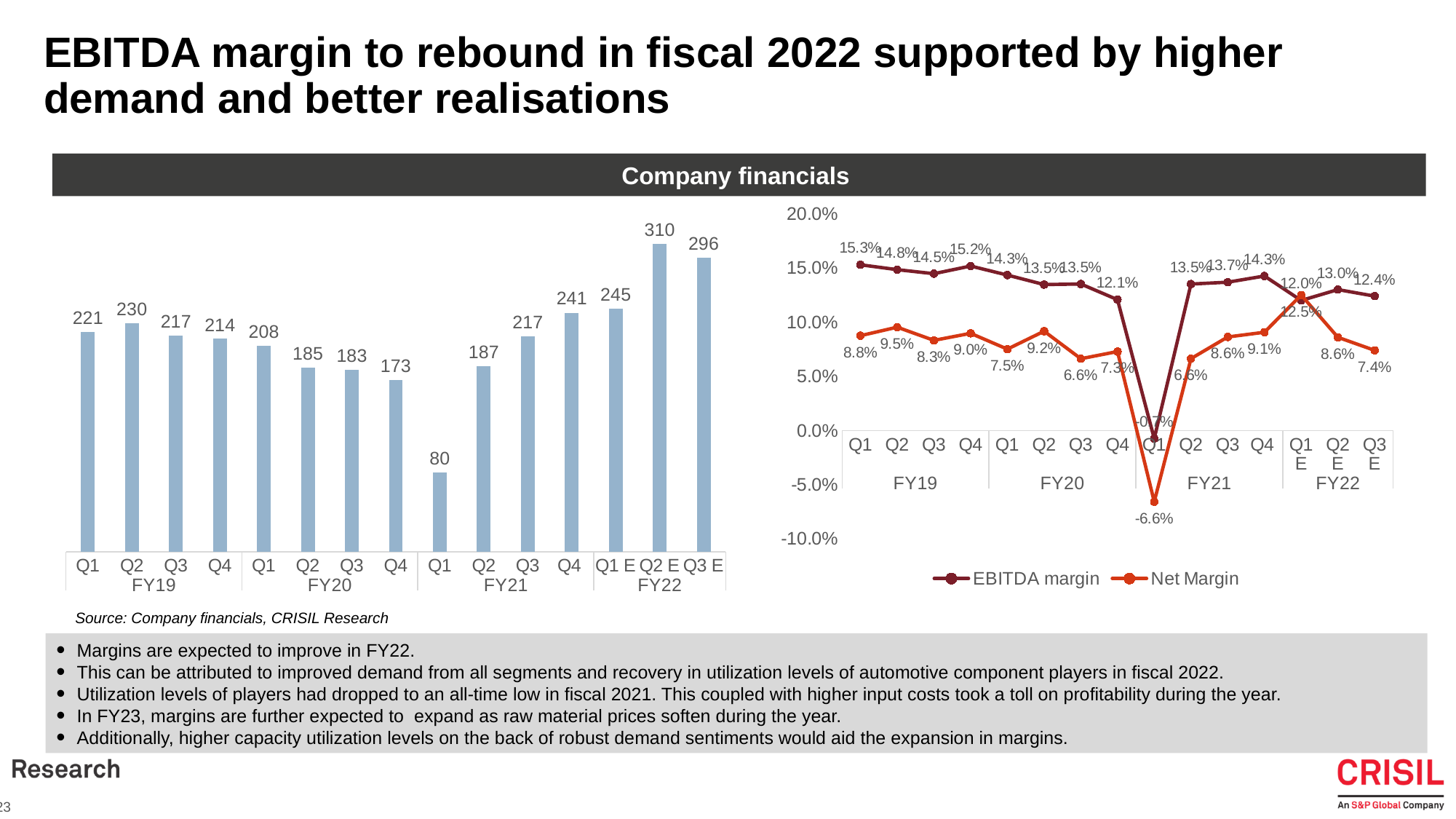
In the line chart on the right, what is the difference between the EBITDA margin and the Net Margin in Q3 of FY22 E? 5.0% In the line chart on the right, what is the Net Margin for Q1 of FY21? -6.6% In the bar chart on the left, how many bars are plotted? 15 In the bar chart on the left, what is the difference between Q4 FY21 and Q1 FY21? 161 In the line chart on the right, how many series does the legend list? 2 What type of chart is shown on the left side of the slide? Bar chart In the bar chart on the left, what is the value for Q1 of FY21? 80 In the bar chart on the left, which quarter has the highest value? Q2 E FY22 In the bar chart on the left, which quarter has the lowest value? Q1 FY21 In the bar chart on the left, which is larger: Q1 FY19 or Q1 FY20? Q1 FY19 In the line chart on the right, what is the EBITDA margin for Q1 of FY19? 15.3% In the bar chart on the left, what is the value for Q2 of FY22 E? 310